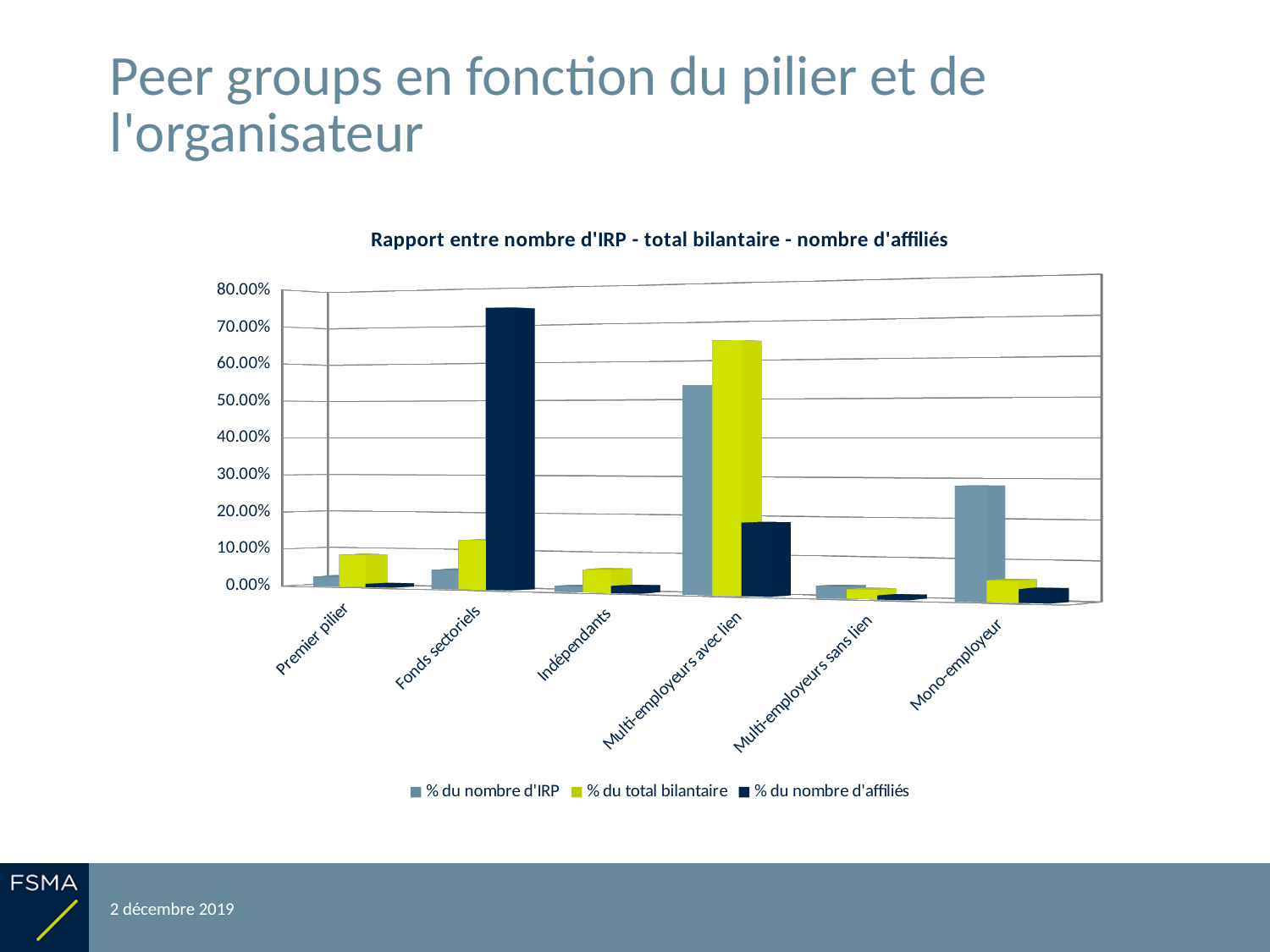
How many series does the chart legend list? 3 Which category has the highest value for % du nombre d'affiliés? Fonds sectoriels Is the value of % du total bilantaire for Multi-employeurs avec lien greater or less than 60.00%? greater Which is larger: % du nombre d'affiliés for Fonds sectoriels or % du nombre d'affiliés for Multi-employeurs avec lien? Fonds sectoriels Which category has the highest value for % du nombre d'IRP? Multi-employeurs avec lien Is the value of % du nombre d'IRP for Mono-employeur greater or less than 20.00%? greater How many categories are shown on the x axis of the chart? 6 Which category has the highest value for % du total bilantaire? Multi-employeurs avec lien What is the title of the chart? Rapport entre nombre d'IRP - total bilantaire - nombre d'affiliés For Mono-employeur, which is larger: % du nombre d'IRP or % du total bilantaire? % du nombre d'IRP What kind of chart is shown on the slide? bar chart Is the value of % du nombre d'affiliés for Fonds sectoriels greater or less than 60.00%? greater